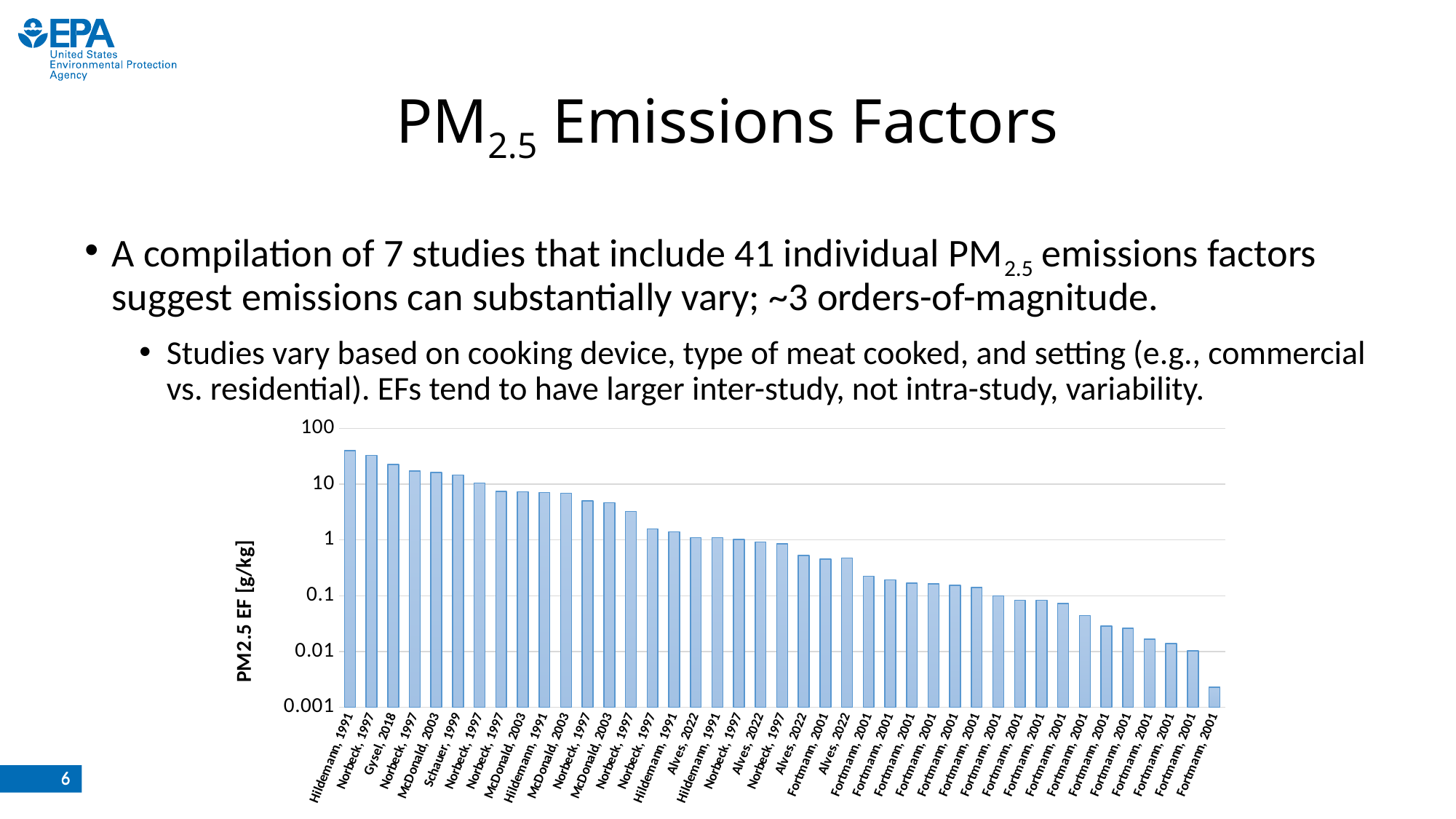
What is the label of the y axis of the chart? PM2.5 EF [g/kg] What kind of chart is shown on the slide? bar chart Which category has the lowest PM2.5 EF in the chart? Fortmann, 2001 (rightmost bar) Is the value for Gysel, 2018 greater or less than 10? greater How many bars are plotted in the chart? 41 Which category has the highest PM2.5 EF in the chart? Hildemann, 1991 (leftmost bar) What is the highest tick value shown on the y axis of the chart? 100 Which has the larger PM2.5 EF, Gysel, 2018 or Schauer, 1999? Gysel, 2018 Is the value of the tallest bar greater or less than 100? less Is the value for Schauer, 1999 greater or less than 10? greater Do the bar values rise or fall from left to right along the x axis? fall